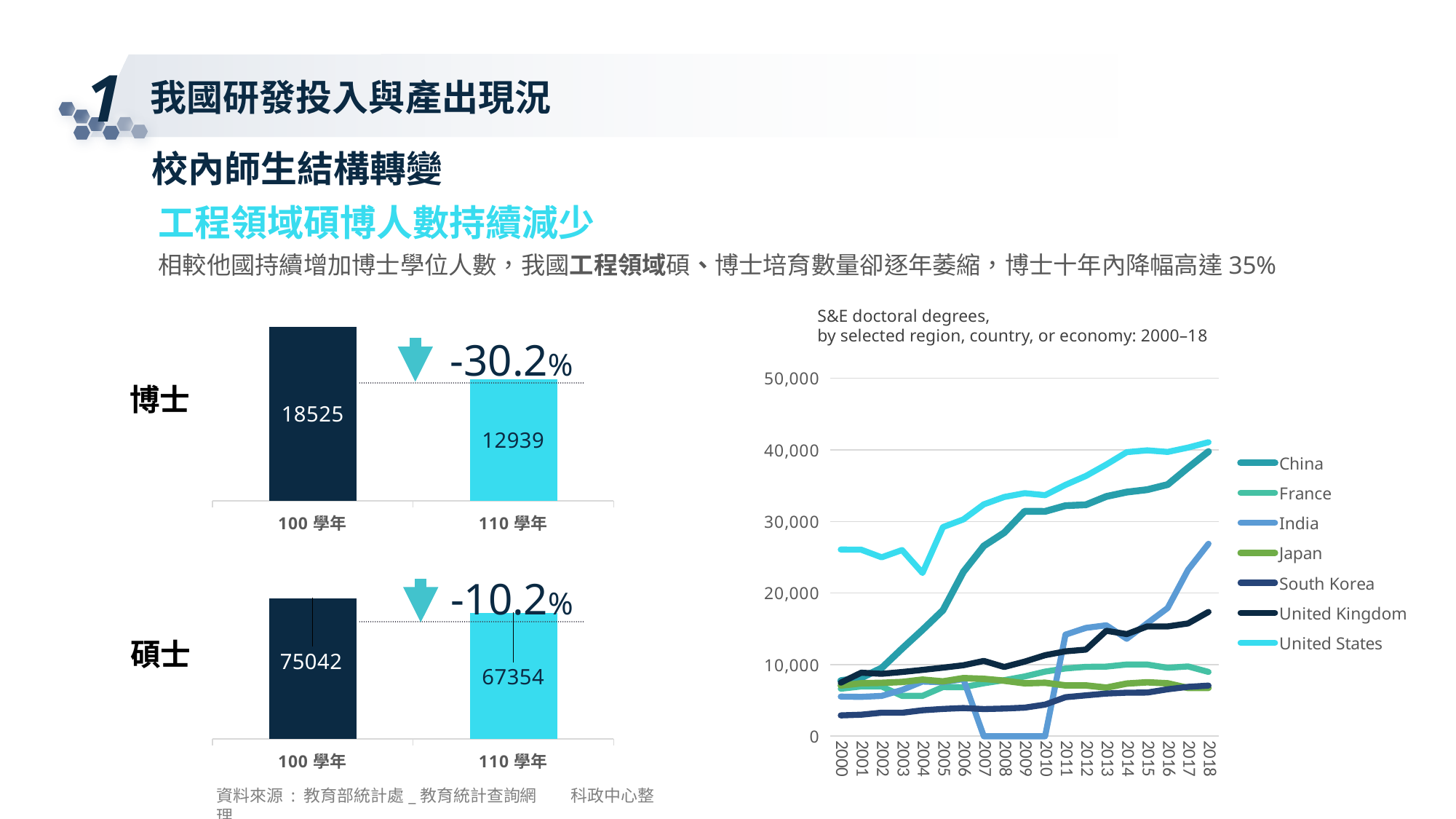
In the S&E doctoral degrees line chart, is the value for India in 2018 greater or less than 20,000? greater How many series does the legend of the S&E doctoral degrees line chart list? 7 In the 碩士 bar chart, what is the difference between the 100 學年 and 110 學年 values? 7688 In the 博士 bar chart, what is the value for 110 學年? 12939 In the 博士 bar chart, what is the difference between the 100 學年 and 110 學年 values? 5586 In the S&E doctoral degrees line chart, does the China series rise or fall from 2000 to 2018? rise In the 碩士 bar chart, what is the value for 110 學年? 67354 In the 博士 bar chart, what is the value for 100 學年? 18525 What kind of chart is the S&E doctoral degrees chart on the right? line chart In the 碩士 bar chart, what is the value for 100 學年? 75042 In the 博士 bar chart, what percentage change is shown between 100 學年 and 110 學年? -30.2% In the 碩士 bar chart, which is larger, the value for 100 學年 or 110 學年? 100 學年